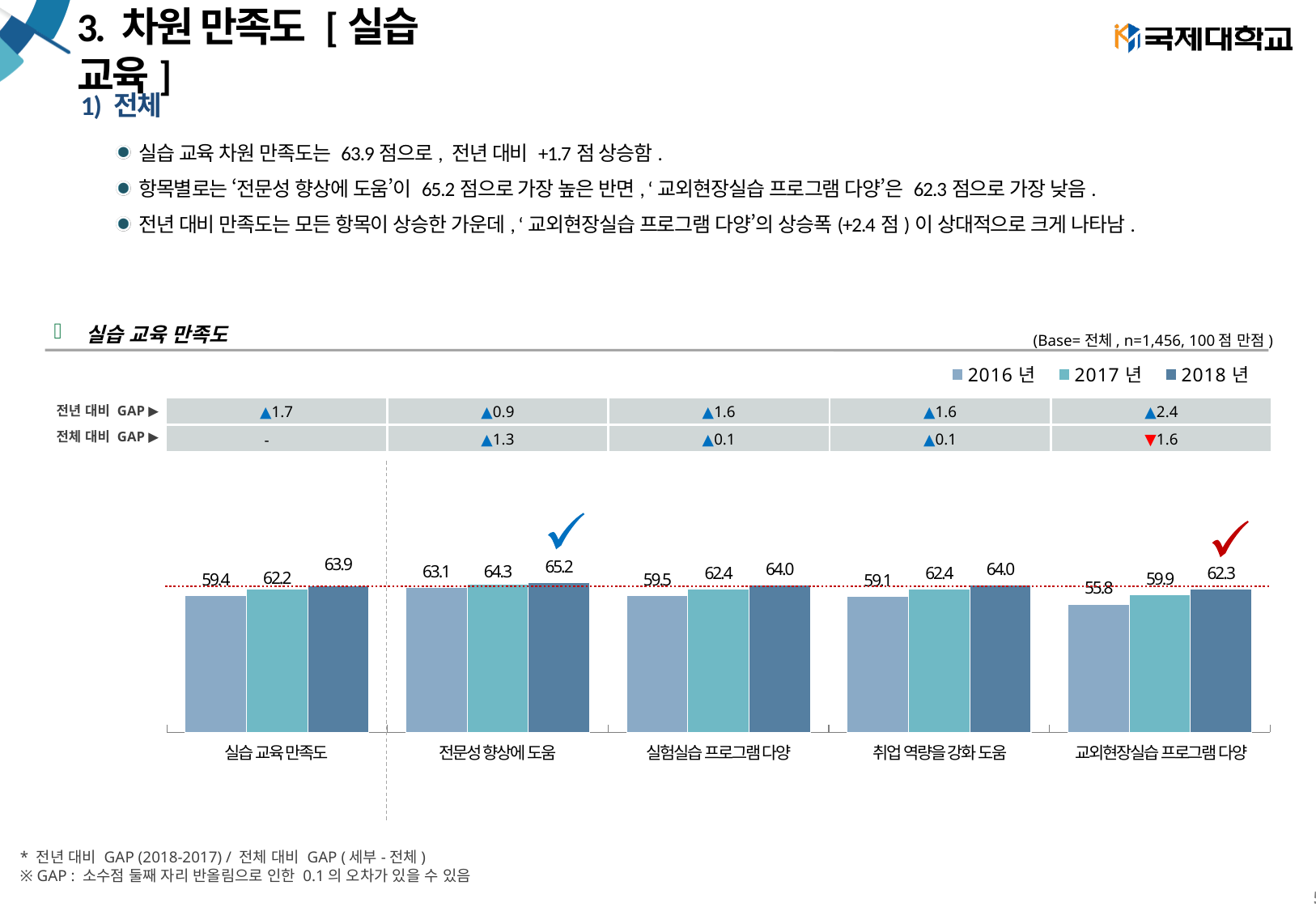
Which category has the lowest 2016년 value? 교외현장실습 프로그램 다양 Which is larger: the 2017년 value for 전문성 향상에 도움 or the 2017년 value for 취업 역량을 강화 도움? 전문성 향상에 도움 What kind of chart is shown on the slide? bar chart How many series does the legend list? 3 Which category has the highest 2018년 value? 전문성 향상에 도움 How many categories are shown on the x axis of the chart? 5 What is the 2016년 value for 교외현장실습 프로그램 다양? 55.8 What is the title of the chart? 실습 교육 만족도 Do the values for 실험실습 프로그램 다양 rise or fall from 2016년 to 2018년? rise What is the difference between the 2018년 and 2016년 values for 교외현장실습 프로그램 다양? 6.5 What is the 2018년 value for 전문성 향상에 도움? 65.2 What is the 2017년 value for 실습 교육 만족도? 62.2